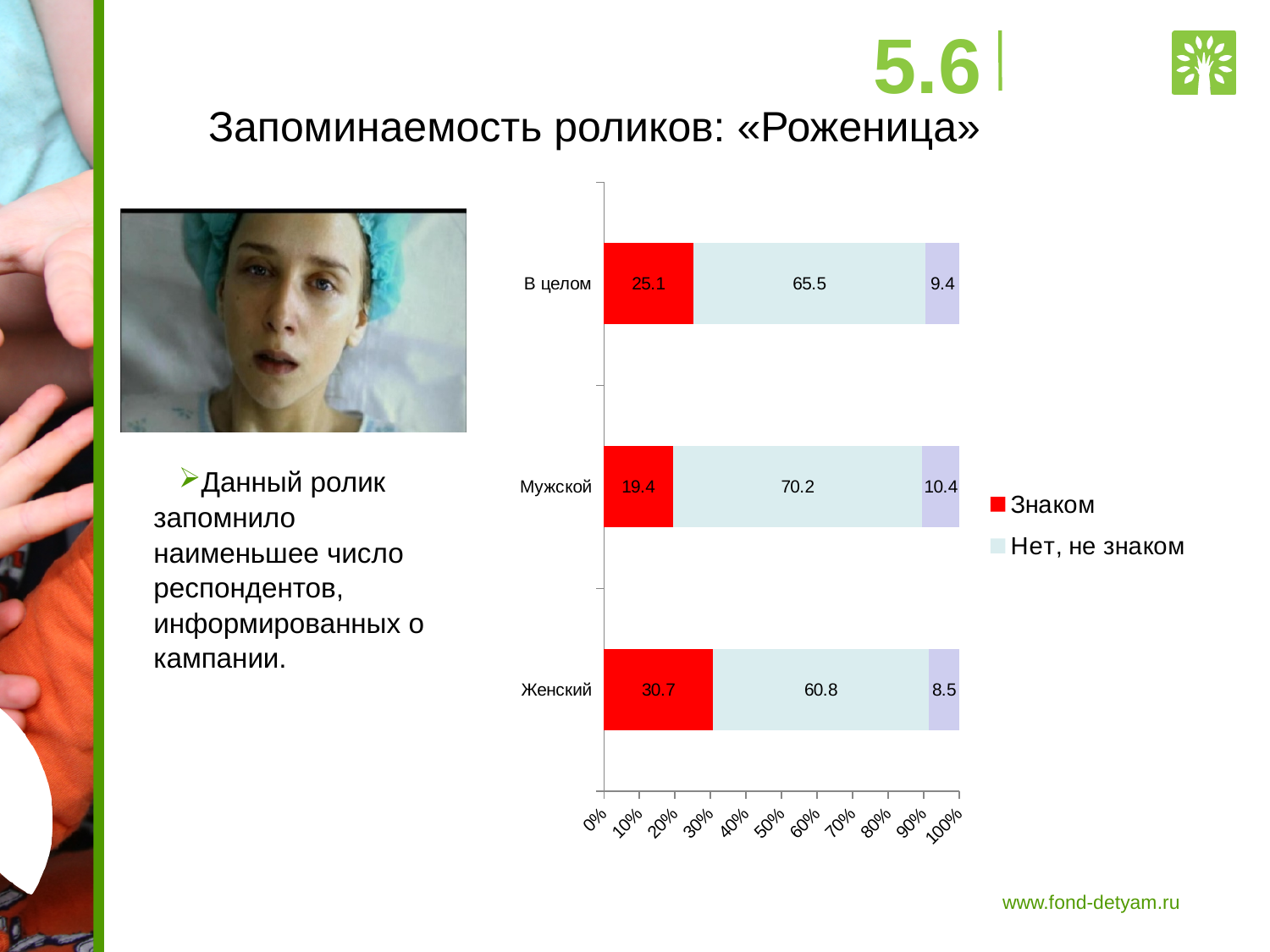
What is the value of «Нет, не знаком» for «Мужской»? 70.2 What is the value of «Нет, не знаком» for «В целом»? 65.5 What is the title of the slide containing the chart? Запоминаемость роликов: «Роженица» Which category has the lowest value for «Знаком»? Мужской Which is larger: the «Нет, не знаком» value for «Мужской» or for «Женский»? Мужской What is the value of «Знаком» for «Женский»? 30.7 Which category has the highest value for «Знаком»? Женский What is the value of «Знаком» for «В целом»? 25.1 How many categories are shown on the chart? 3 How many series does the legend list? 2 What kind of chart is shown on the slide? Stacked bar chart What is the difference between the «Знаком» values for «Женский» and «Мужской»? 11.3